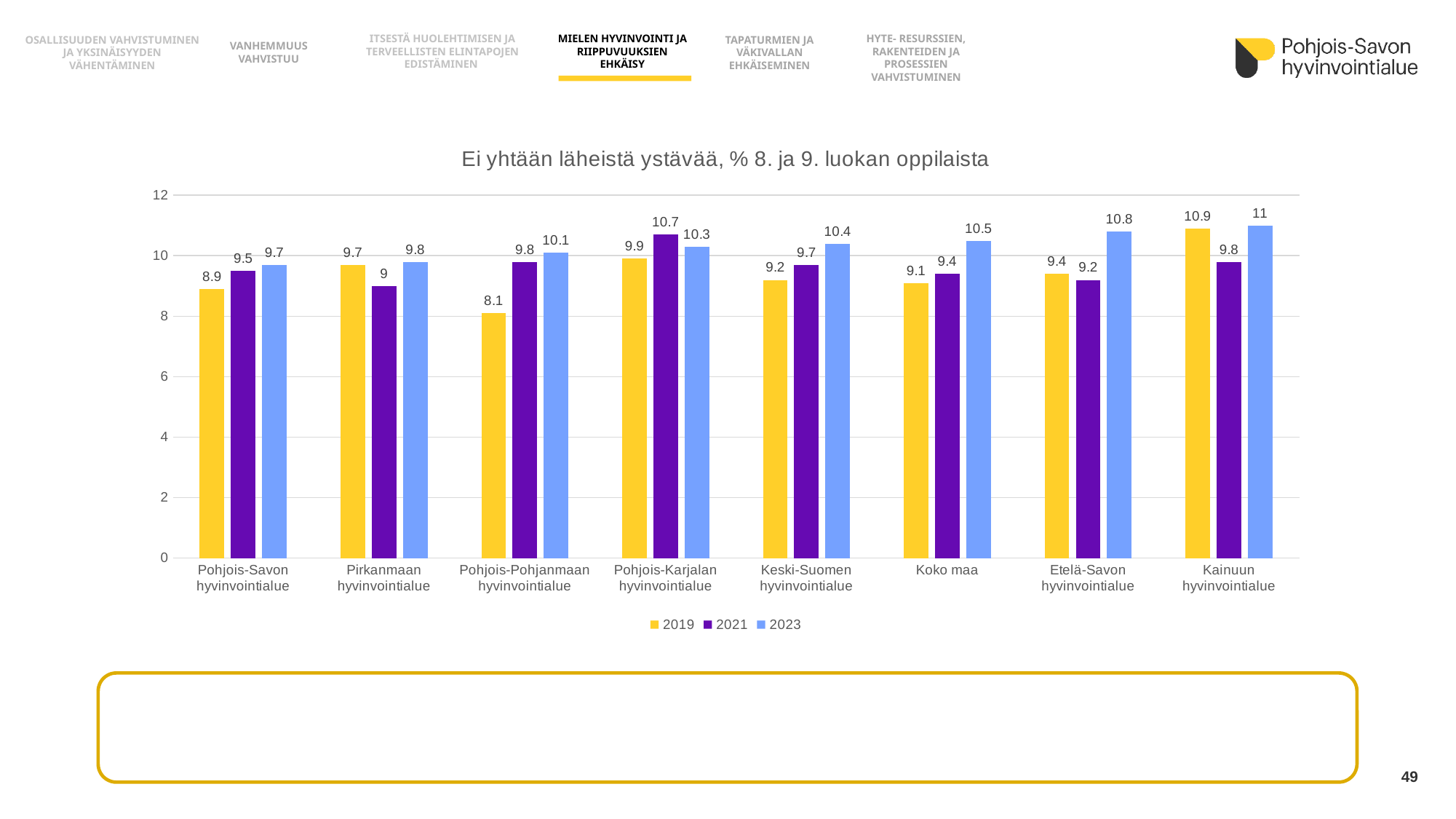
What is the 2019 value for Pohjois-Pohjanmaan hyvinvointialue? 8.1 How many categories are shown on the x axis? 8 How many series does the legend list? 3 Which is larger for Pohjois-Karjalan hyvinvointialue, the 2021 value or the 2023 value? 2021 What is the 2021 value for Pirkanmaan hyvinvointialue? 9 What is the 2023 value for Pohjois-Savon hyvinvointialue? 9.7 Is the 2023 value for Koko maa greater or less than 10? greater What is the title of the chart? Ei yhtään läheistä ystävää, % 8. ja 9. luokan oppilaista Which category has the highest 2023 value? Kainuun hyvinvointialue What is the difference between the 2023 and 2019 values for Etelä-Savon hyvinvointialue? 1.4 What kind of chart is shown on the slide? Bar chart Which category has the lowest 2019 value? Pohjois-Pohjanmaan hyvinvointialue